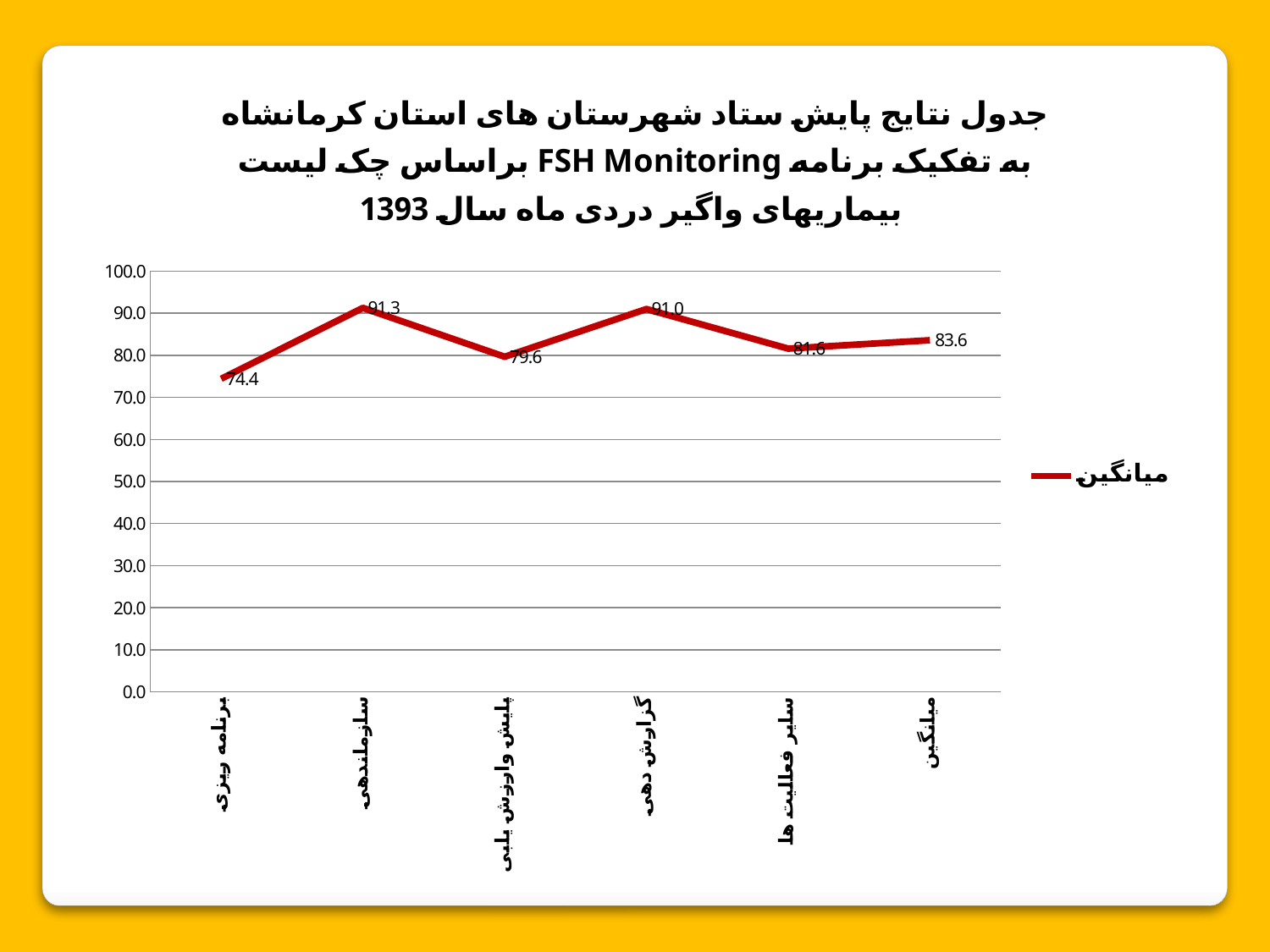
Which category has the highest value? سازماندهی Which is larger, the value for سایر فعالیت ها or the value for میانگین? میانگین What is the value for سایر فعالیت ها? 81.6 What is the value for میانگین? 83.6 What type of chart is shown on the slide? line chart Which category has the lowest value? برنامه ریزی What is the value for سازماندهی? 91.3 How many series does the legend list? 1 What is the difference between the values for سازماندهی and برنامه ریزی? 16.9 What is the value for گزارش دهی? 91.0 What is the value for برنامه ریزی? 74.4 How many categories are plotted on the x axis? 6